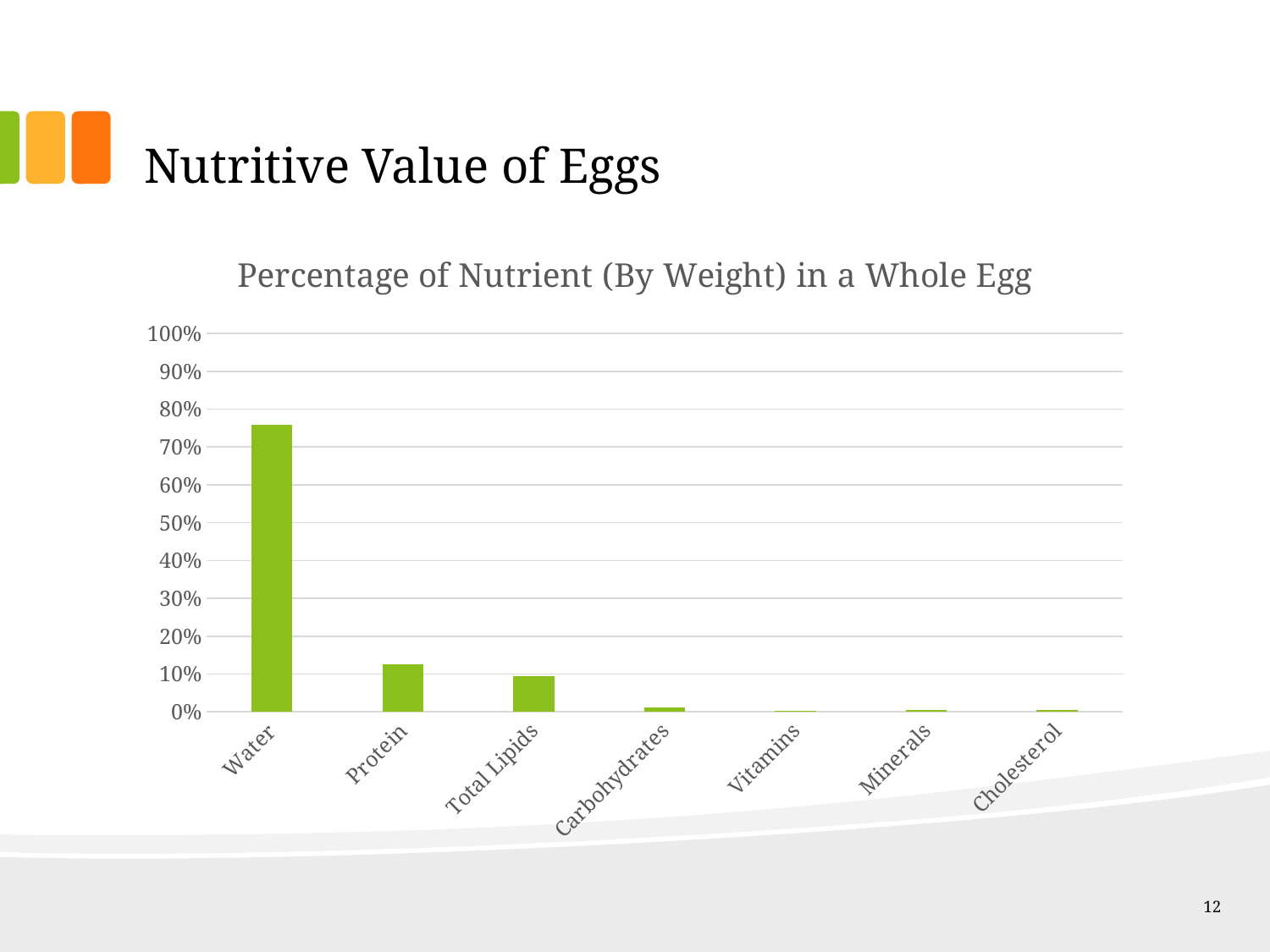
How many nutrient categories are shown on the x axis? 7 Is the value for Water greater or less than 70%? greater What kind of chart is shown on the slide? bar chart Which nutrient has the highest percentage by weight? Water Is the value for Carbohydrates greater or less than 10%? less Which is larger, the value for Water or the value for Protein? Water Do the values generally rise or fall moving from left to right along the x axis? fall Is the value for Protein greater or less than 10%? greater Which is larger, the value for Protein or the value for Total Lipids? Protein What is the title of the chart? Percentage of Nutrient (By Weight) in a Whole Egg